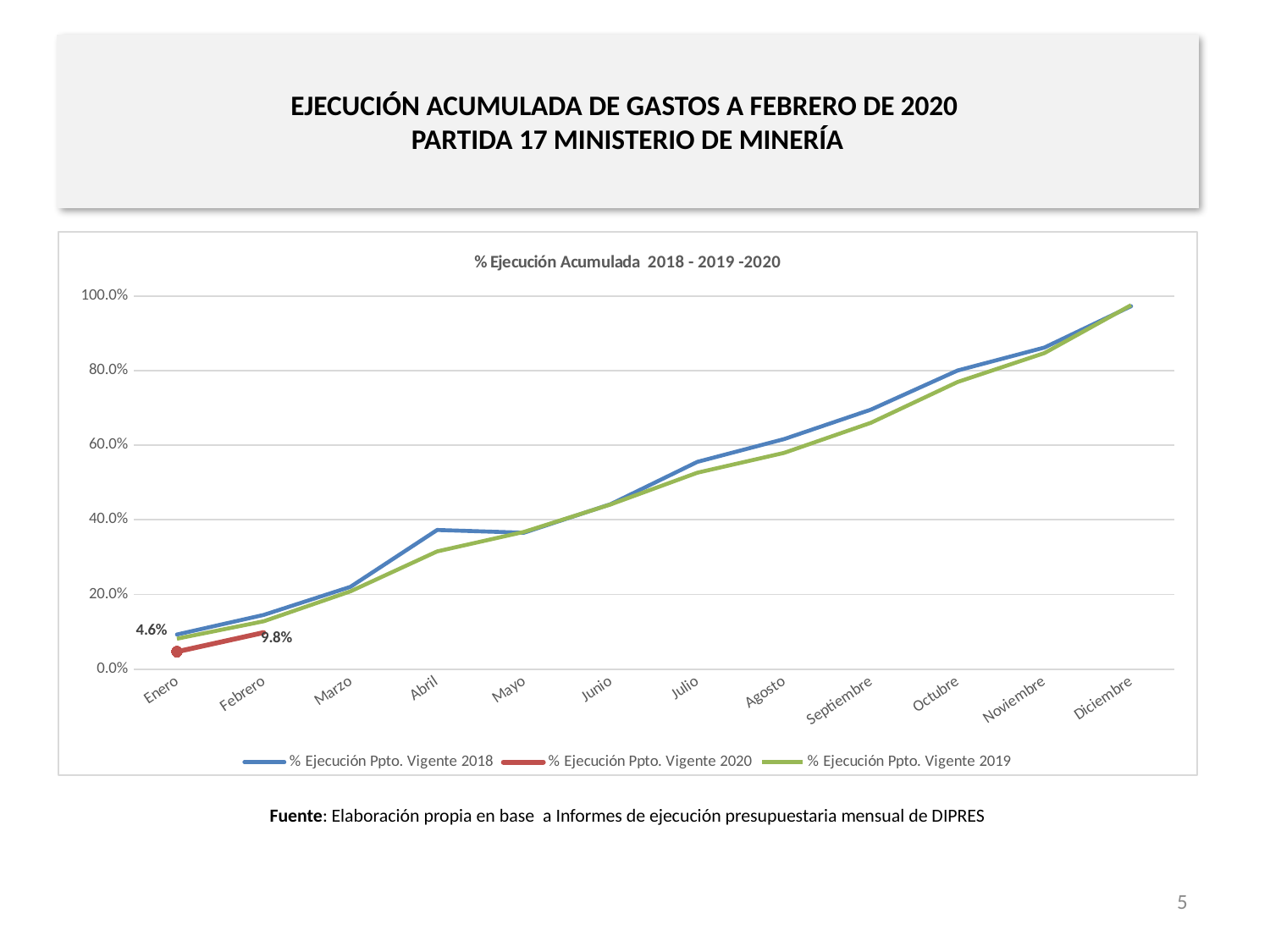
Do the values for % Ejecución Ppto. Vigente 2018 rise or fall from Enero to Diciembre? rise Is the value for % Ejecución Ppto. Vigente 2019 in Abril greater or less than 40%? less What is the value of % Ejecución Ppto. Vigente 2020 for Enero? 4.6% Is the value for % Ejecución Ppto. Vigente 2018 in Julio greater or less than 40%? greater In which month does % Ejecución Ppto. Vigente 2018 reach its highest value? Diciembre By how much did % Ejecución Ppto. Vigente 2020 increase from Enero to Febrero? 5.2% What kind of chart is shown on the slide? line chart How many series does the legend list? 3 What is the value of % Ejecución Ppto. Vigente 2020 for Febrero? 9.8% What is the title of the chart? % Ejecución Acumulada 2018 - 2019 -2020 In Abril, which series has the higher value: % Ejecución Ppto. Vigente 2018 or % Ejecución Ppto. Vigente 2019? % Ejecución Ppto. Vigente 2018 How many months are shown on the x axis? 12